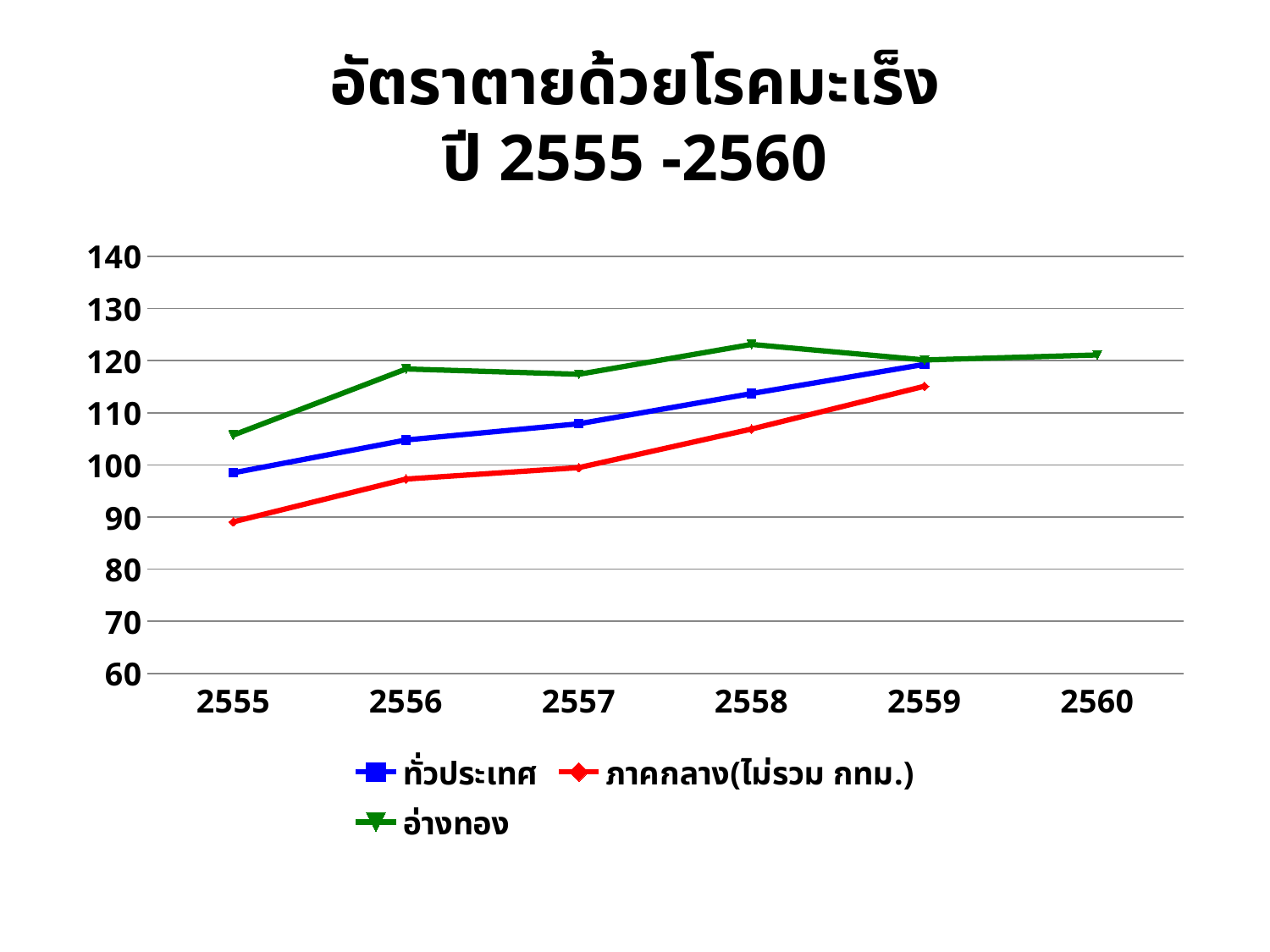
Is the value for อ่างทอง in 2555 greater or less than 100? greater In which year is the value for อ่างทอง lowest? 2555 What is the title of the chart? อัตราตายด้วยโรคมะเร็ง ปี 2555 -2560 Is the value for ทั่วประเทศ in 2559 greater or less than 110? greater How many years are shown on the x axis? 6 How many series does the legend list? 3 Is the value for อ่างทอง in 2558 greater or less than 120? greater Does the value for ทั่วประเทศ rise or fall from 2555 to 2559? rise Which series is drawn in green? อ่างทอง In 2555, which is larger: the value for อ่างทอง or for ภาคกลาง(ไม่รวม กทม.)? อ่างทอง What kind of chart is shown on the slide? line chart